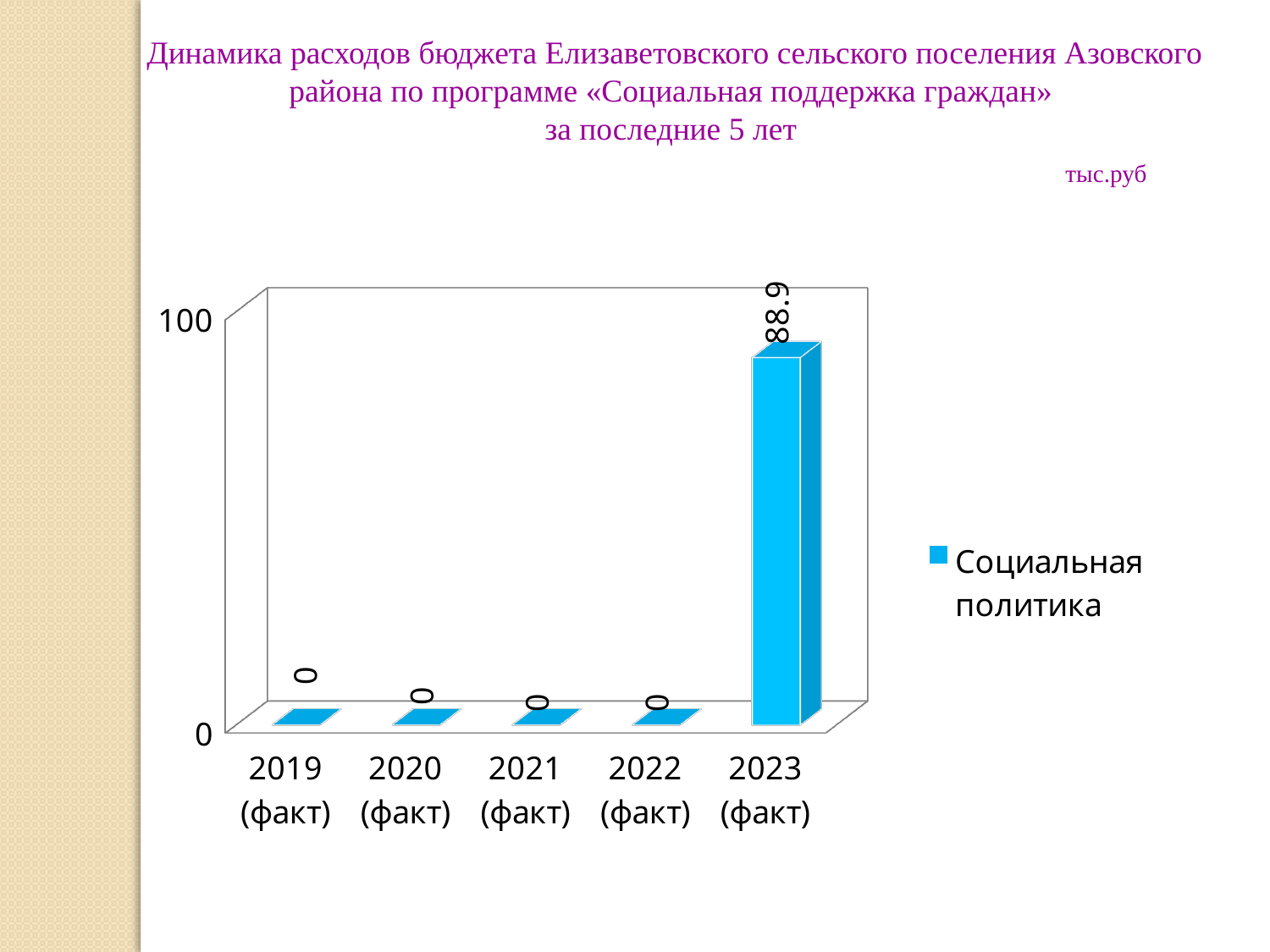
What is the name of the series in the legend? Социальная политика What is the value for 2021 (факт)? 0 What is the value for 2019 (факт)? 0 Which year has the highest value? 2023 (факт) What unit is indicated for the values on the slide? тыс.руб Which is larger, the value for 2020 (факт) or the value for 2023 (факт)? 2023 (факт) What is the difference between the values for 2023 (факт) and 2022 (факт)? 88.9 What kind of chart is shown on the slide? bar chart How many categories are shown on the x axis? 5 How many series does the legend list? 1 Is the value for 2023 (факт) greater or less than 100? less What is the value for 2023 (факт)? 88.9